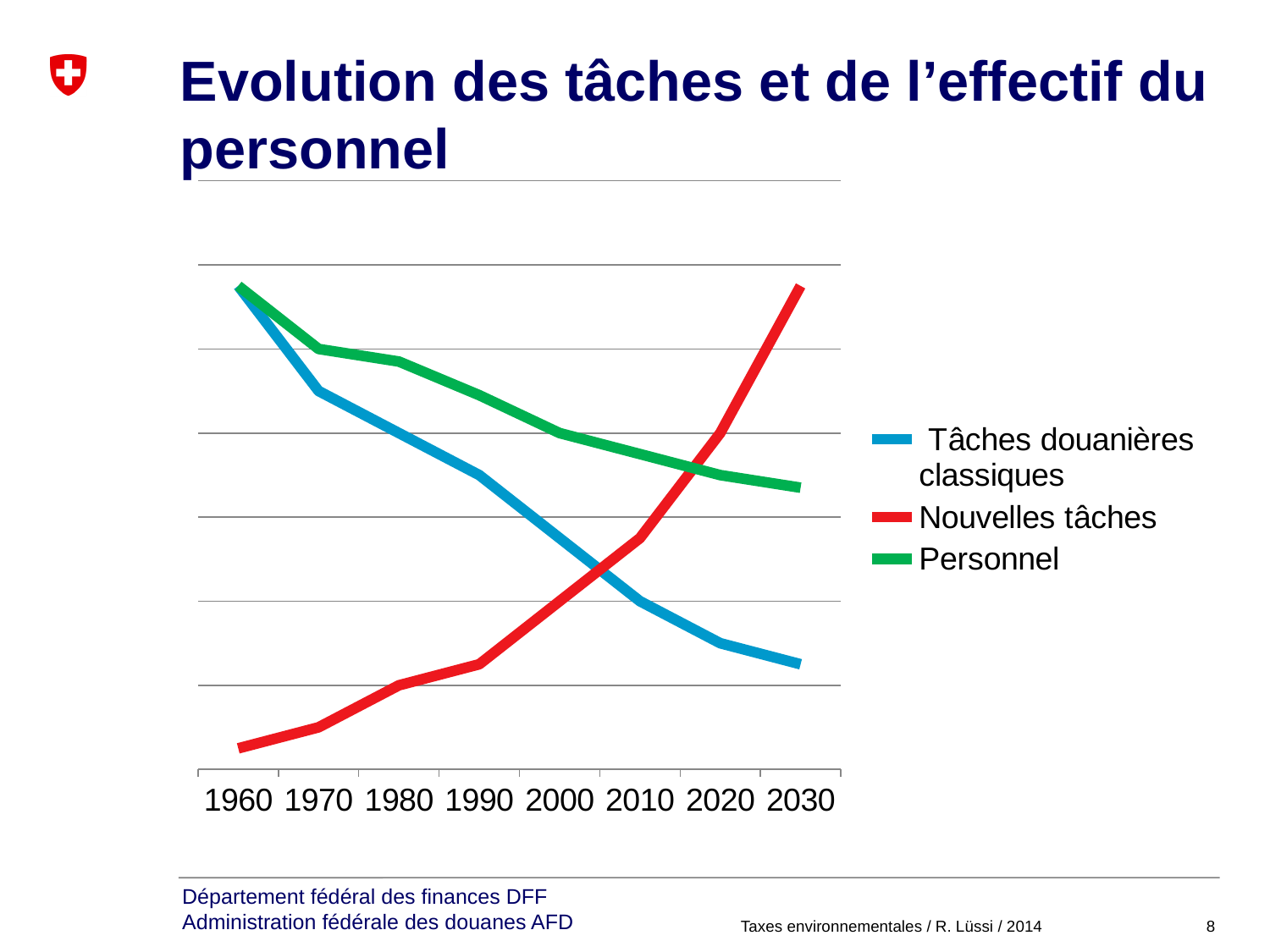
Does the 'Personnel' line rise or fall from 1960 to 2030? fall Which colour is used for the 'Personnel' series? green Does the 'Nouvelles tâches' line rise or fall from 1960 to 2030? rise In which year does the 'Nouvelles tâches' series reach its highest value? 2030 In which year does the 'Nouvelles tâches' series have its lowest value? 1960 In which year does the 'Tâches douanières classiques' series have its lowest value? 2030 Does the 'Tâches douanières classiques' line rise or fall from 1960 to 2030? fall In 1980, which is larger: 'Tâches douanières classiques' or 'Nouvelles tâches'? Tâches douanières classiques What kind of chart is shown on the slide? line chart How many years are marked along the x axis? 8 In 2030, which is larger: 'Nouvelles tâches' or 'Personnel'? Nouvelles tâches How many series does the legend list? 3